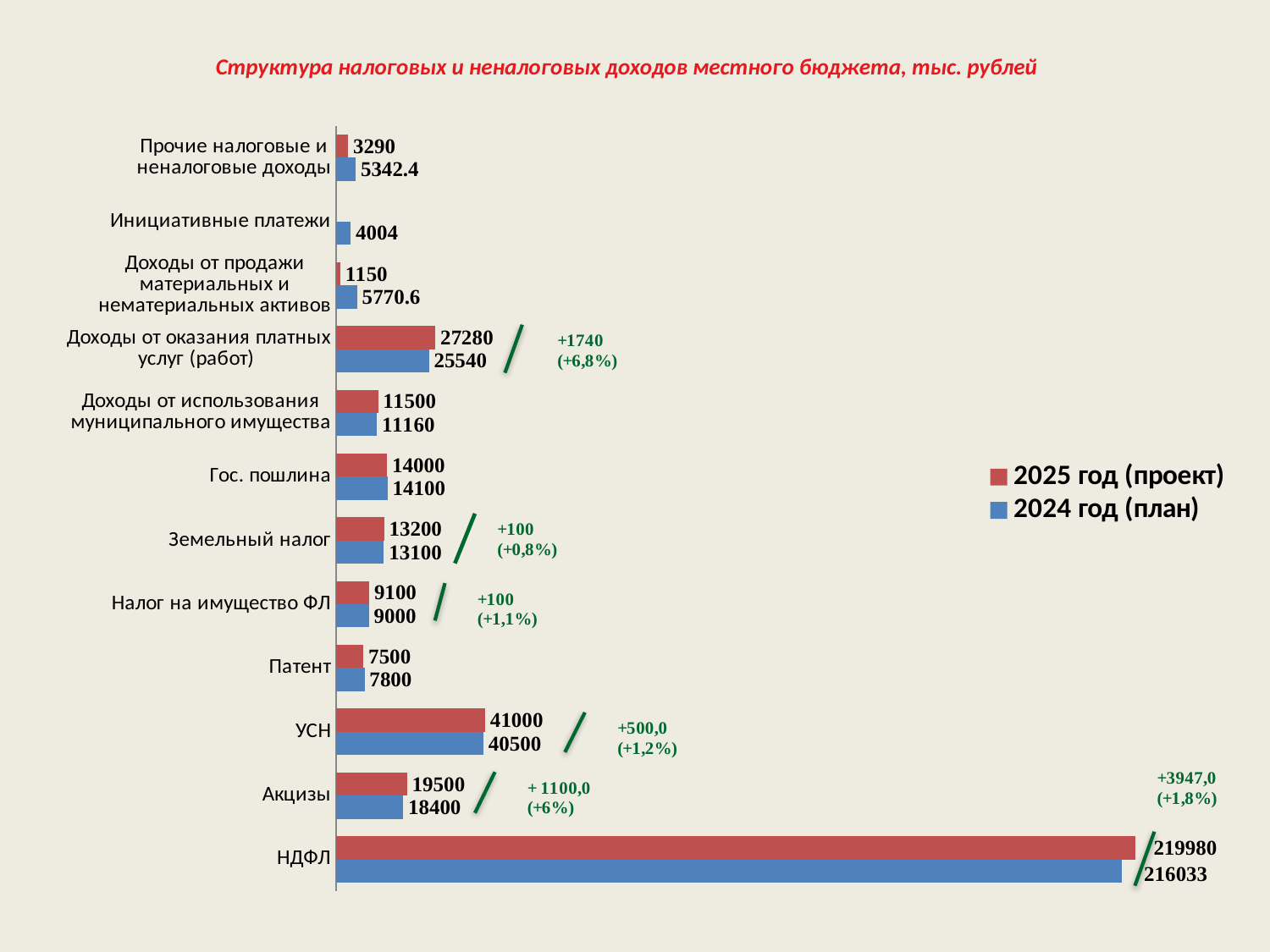
Which category has the lowest value in the 2025 год (проект) series? Доходы от продажи материальных и нематериальных активов How many categories are shown on the chart? 12 Which category has the highest value in the 2025 год (проект) series? НДФЛ What type of chart is shown on the slide? bar chart What is the value for Акцизы in the 2025 год (проект) series? 19500 What is the value for Инициативные платежи in the 2024 год (план) series? 4004 What is the difference between the 2025 год (проект) and 2024 год (план) values for Доходы от оказания платных услуг (работ)? 1740 What is the value for НДФЛ in the 2025 год (проект) series? 219980 What is the value for УСН in the 2024 год (план) series? 40500 What colour represents the 2024 год (план) series? blue How many series does the legend list? 2 Which is larger for Патент: the 2025 год (проект) value or the 2024 год (план) value? 2024 год (план)